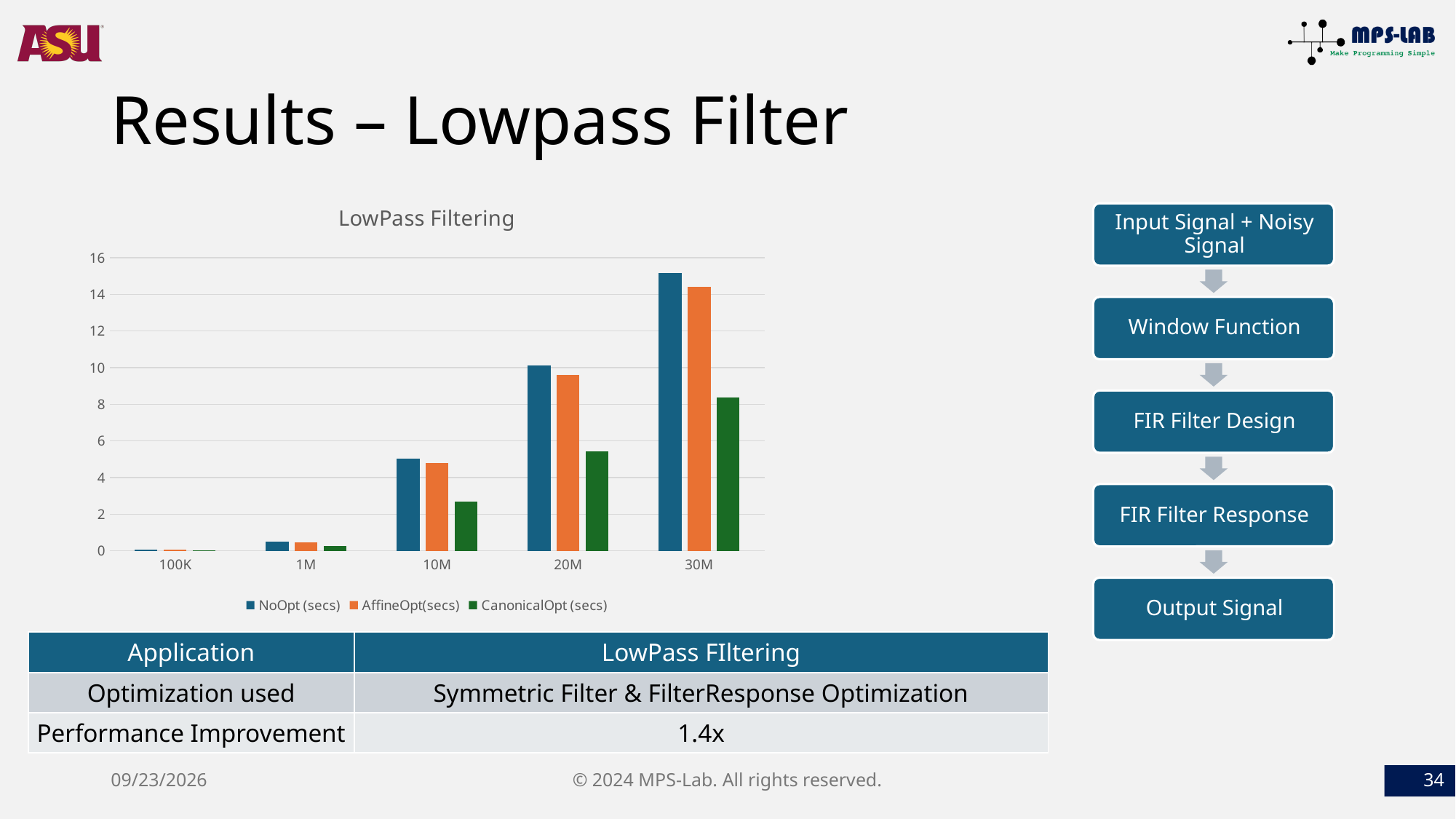
What kind of chart is shown on the slide? bar chart At 30M, which is larger: the NoOpt (secs) value or the CanonicalOpt (secs) value? NoOpt (secs) What is the title of the chart? LowPass Filtering How many categories are shown on the x axis of the chart? 5 Which category has the highest NoOpt (secs) value? 30M How many series does the chart legend list? 3 Is the NoOpt (secs) value for 30M greater or less than 14? greater Is the CanonicalOpt (secs) value for 30M greater or less than 10? less Do the NoOpt (secs) values rise or fall as the categories go from 100K to 30M? rise Is the CanonicalOpt (secs) value for 10M greater or less than 4? less Which category has the lowest CanonicalOpt (secs) value? 100K